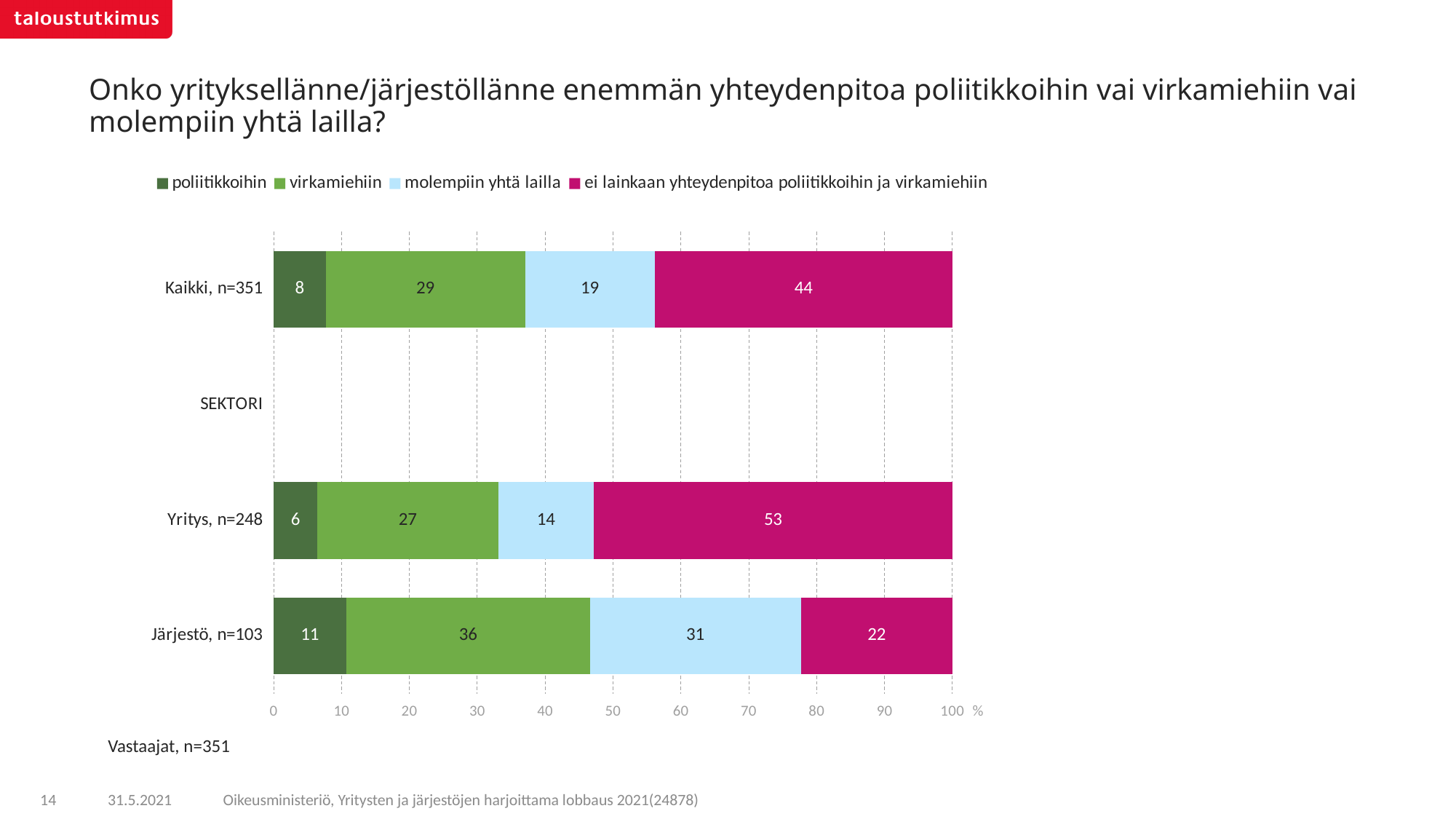
How many bars with data are plotted in the chart? 3 What is the total of the stacked bar for Yritys, n=248? 100 What is the difference between the "ei lainkaan yhteydenpitoa poliitikkoihin ja virkamiehiin" values for Yritys, n=248 and Järjestö, n=103? 31 What kind of chart is shown on the slide? Stacked bar chart How many series does the legend list? 4 Which category has the lowest value for "ei lainkaan yhteydenpitoa poliitikkoihin ja virkamiehiin"? Järjestö, n=103 Which is larger: the "molempiin yhtä lailla" value for Järjestö, n=103 or for Kaikki, n=351? Järjestö, n=103 What is the value for "ei lainkaan yhteydenpitoa poliitikkoihin ja virkamiehiin" in the Kaikki, n=351 bar? 44 What is the value for "virkamiehiin" in the Järjestö, n=103 bar? 36 Which colour represents "virkamiehiin" in the legend? Green Which category has the highest value for "poliitikkoihin"? Järjestö, n=103 What is the value for "molempiin yhtä lailla" in the Yritys, n=248 bar? 14